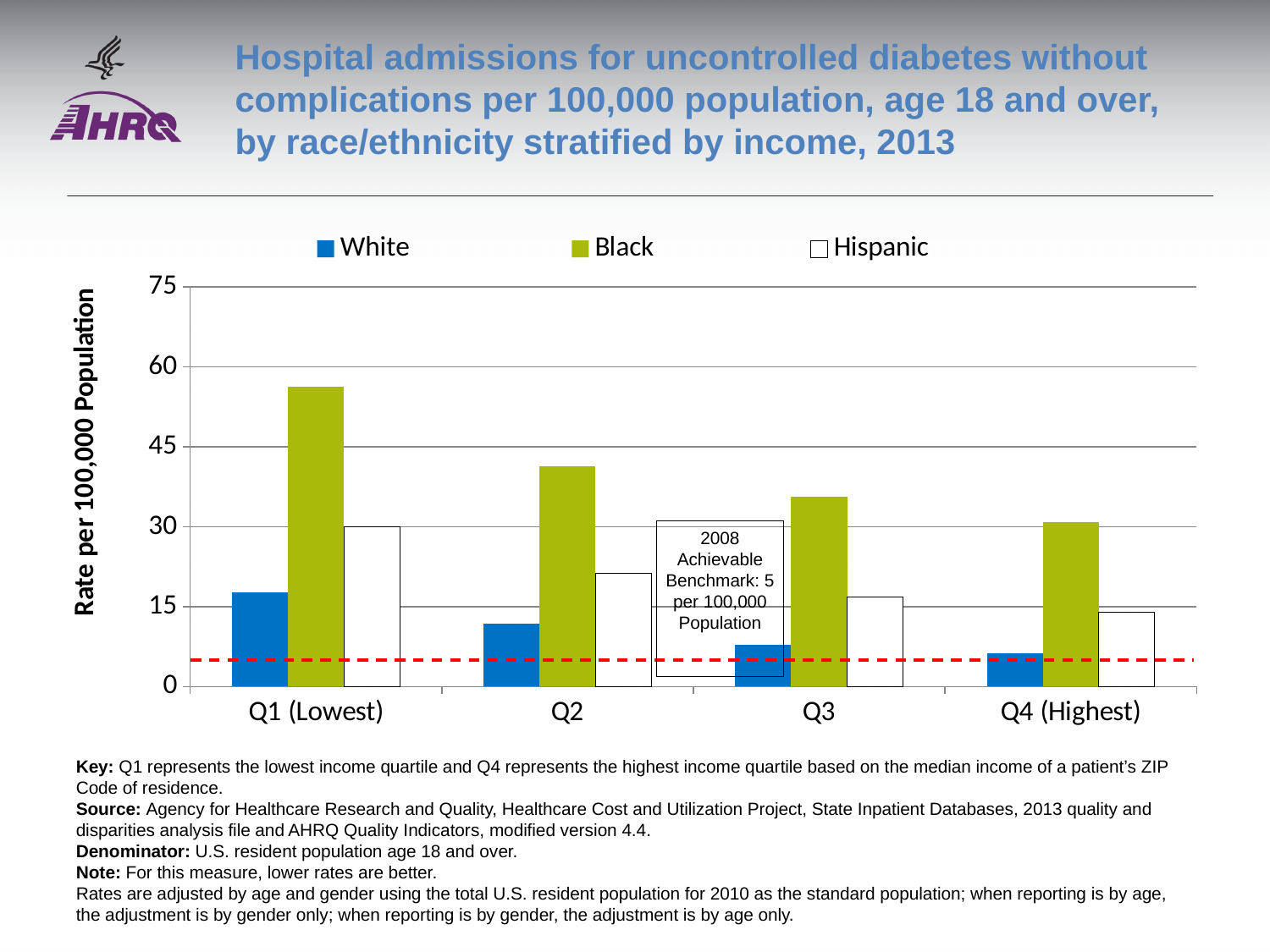
What is the 2008 achievable benchmark shown on the chart? 5 per 100,000 Population What is the title of the y axis? Rate per 100,000 Population In which income quartile is the Black rate highest? Q1 (Lowest) How many series does the legend list? 3 Is the Hispanic rate for Q2 greater or less than 15? greater Do the Black rates rise or fall from Q1 (Lowest) to Q4 (Highest)? Fall Is the White rate for Q4 (Highest) greater or less than 15? less What kind of chart is shown on the slide? Bar chart How many income quartile categories are shown on the x axis? 4 Is the Black rate for Q1 (Lowest) greater or less than 45? greater In which income quartile is the White rate lowest? Q4 (Highest) In Q3, which group has the larger rate, Black or Hispanic? Black